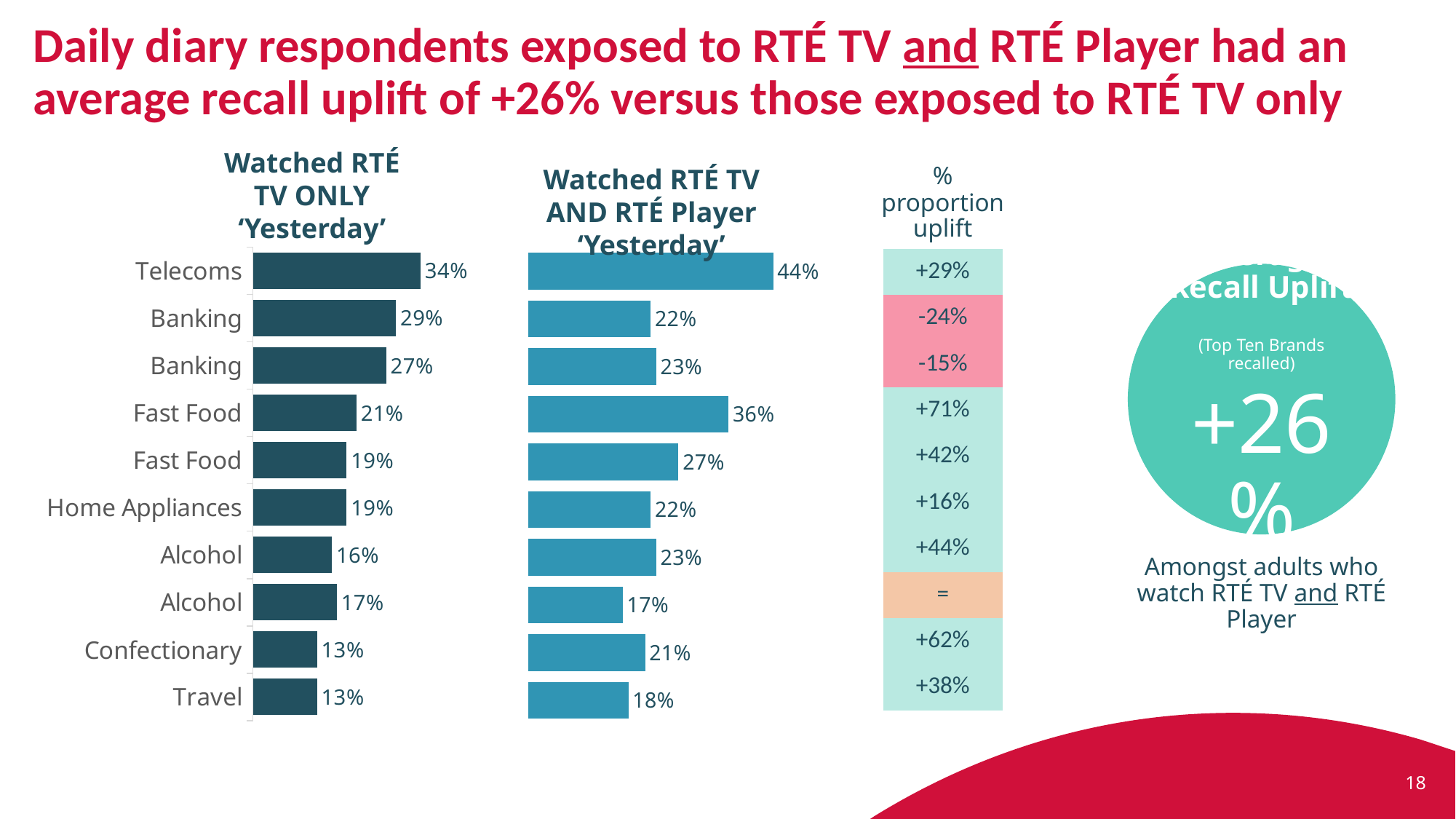
What is the difference between the Confectionary value in the 'Watched RTÉ TV AND RTÉ Player Yesterday' chart and the Confectionary value in the 'Watched RTÉ TV ONLY Yesterday' chart? 8 percentage points How many bars are shown in the 'Watched RTÉ TV ONLY Yesterday' chart? 10 In the 'Watched RTÉ TV AND RTÉ Player Yesterday' chart, what is the value for Confectionary? 21% What type of chart is the 'Watched RTÉ TV ONLY Yesterday' chart? Bar chart In the 'Watched RTÉ TV AND RTÉ Player Yesterday' chart, what is the value for Telecoms? 44% In the 'Watched RTÉ TV AND RTÉ Player Yesterday' chart, what is the value for Travel? 18% What is the difference between the Telecoms value in the 'Watched RTÉ TV AND RTÉ Player Yesterday' chart and the Telecoms value in the 'Watched RTÉ TV ONLY Yesterday' chart? 10 percentage points In the 'Watched RTÉ TV AND RTÉ Player Yesterday' chart, which category has the highest value? Telecoms For Home Appliances, which chart shows the larger value: 'Watched RTÉ TV ONLY Yesterday' or 'Watched RTÉ TV AND RTÉ Player Yesterday'? Watched RTÉ TV AND RTÉ Player 'Yesterday' In the 'Watched RTÉ TV ONLY Yesterday' chart, which category has the highest value? Telecoms In the 'Watched RTÉ TV ONLY Yesterday' chart, what is the value for Home Appliances? 19% In the 'Watched RTÉ TV ONLY Yesterday' chart, what is the value for Telecoms? 34%